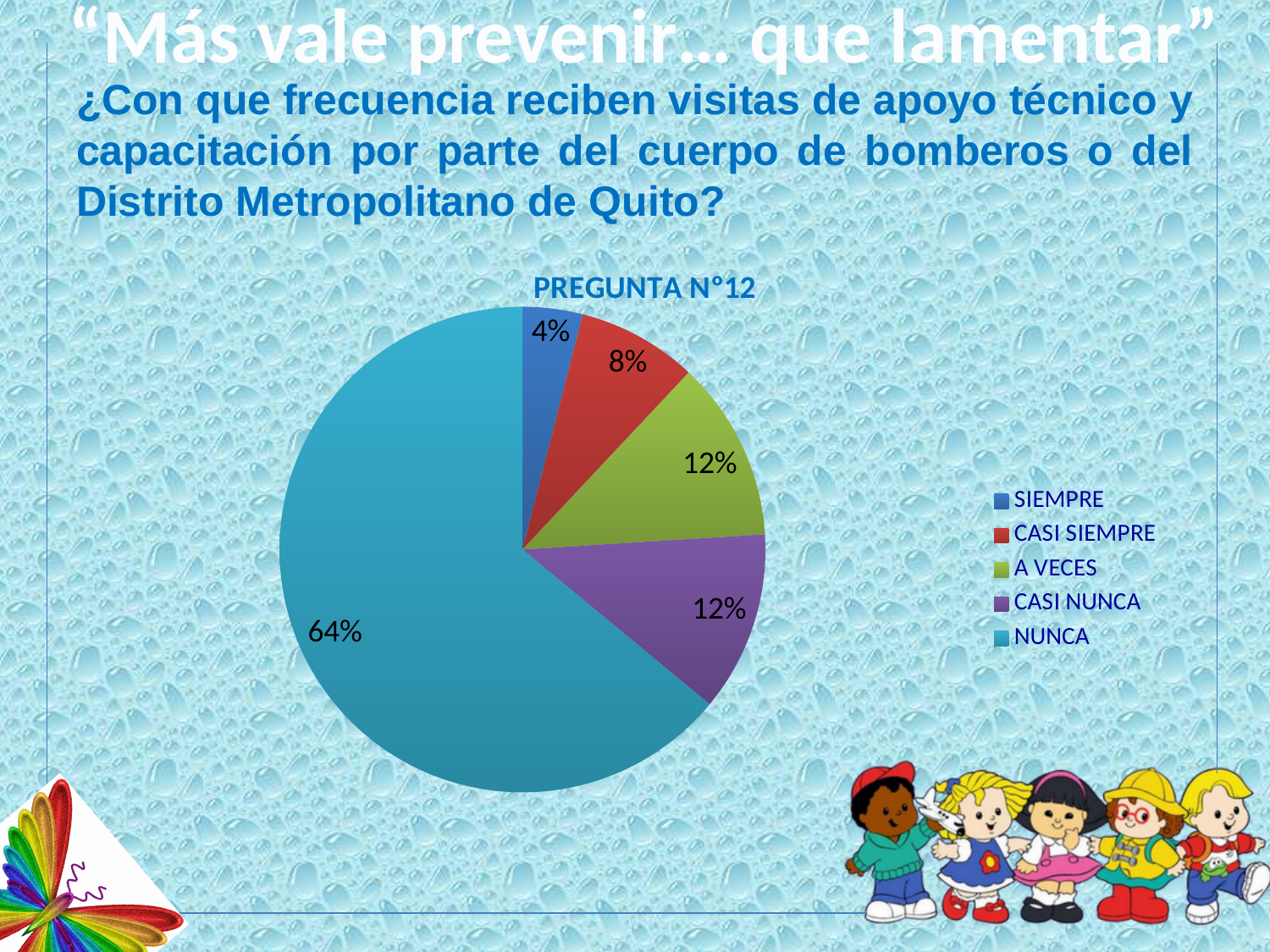
Which is larger, the share for CASI SIEMPRE or the share for SIEMPRE? CASI SIEMPRE What percentage of the pie does CASI SIEMPRE represent? 8% What colour is the NUNCA slice? teal blue What percentage of the pie does A VECES represent? 12% What percentage of the pie does SIEMPRE represent? 4% Which category has the smallest share of the pie? SIEMPRE Which category has the largest share of the pie? NUNCA What kind of chart is shown on the slide? pie chart How many categories does the legend list? 5 What is the difference in percentage points between NUNCA and CASI NUNCA? 52 What is the title of the chart? PREGUNTA N°12 What percentage of the pie does NUNCA represent? 64%